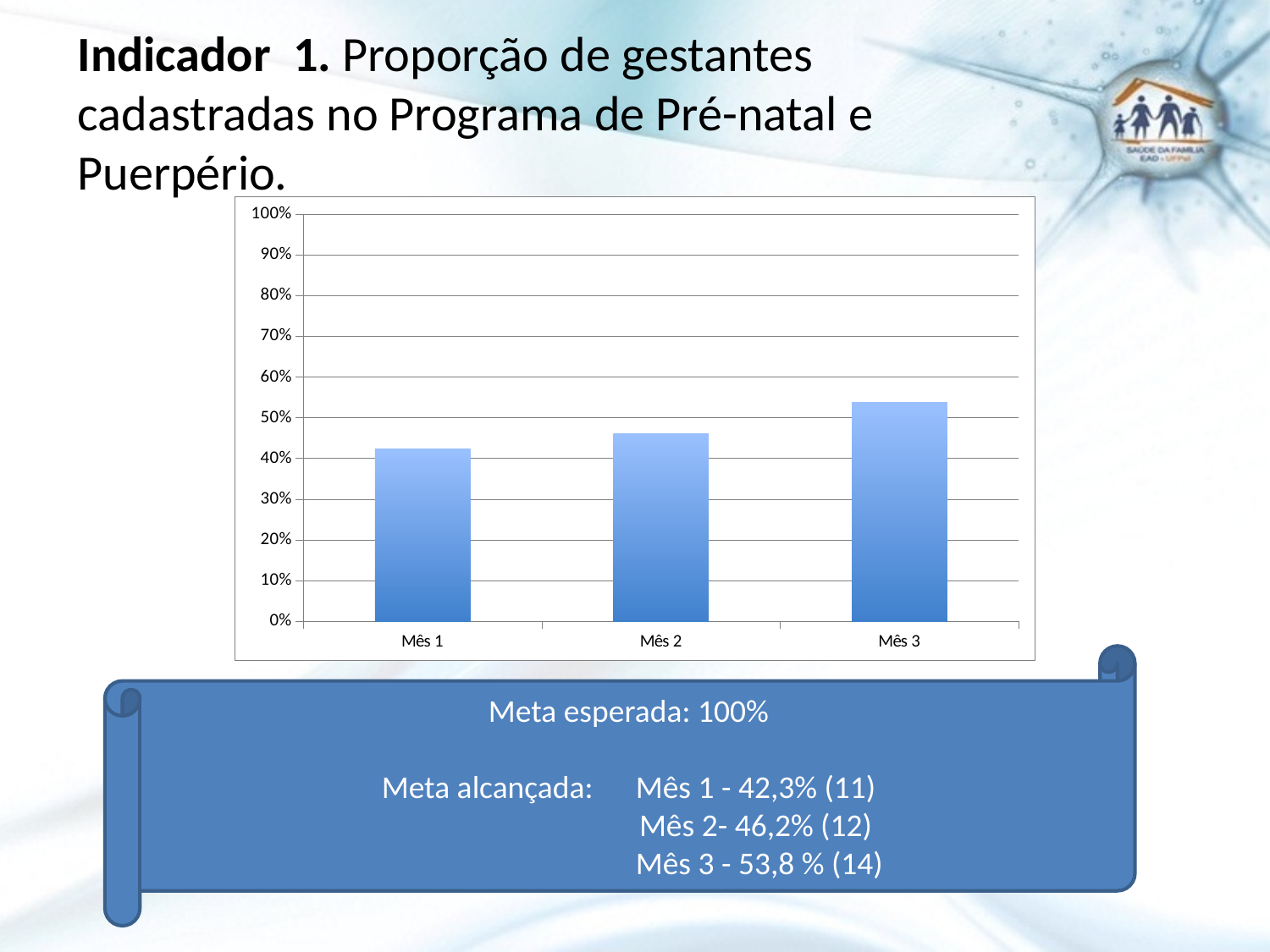
What type of chart is shown on the slide? bar chart Which month has the lowest bar in the chart? Mês 1 Do the values rise or fall from Mês 1 to Mês 3? rise What is the expected target (meta esperada) stated on the slide? 100% Which is larger, the value for Mês 2 or the value for Mês 3? Mês 3 According to the slide, what proportion was achieved in Mês 1? 42,3% Which month has the highest bar in the chart? Mês 3 Is the value for Mês 2 greater or less than 60%? less Is the value for Mês 3 greater or less than 50%? greater How many bars (categories) does the chart show? 3 According to the slide, what proportion was achieved in Mês 3? 53,8 % Is the value for Mês 1 greater or less than 50%? less